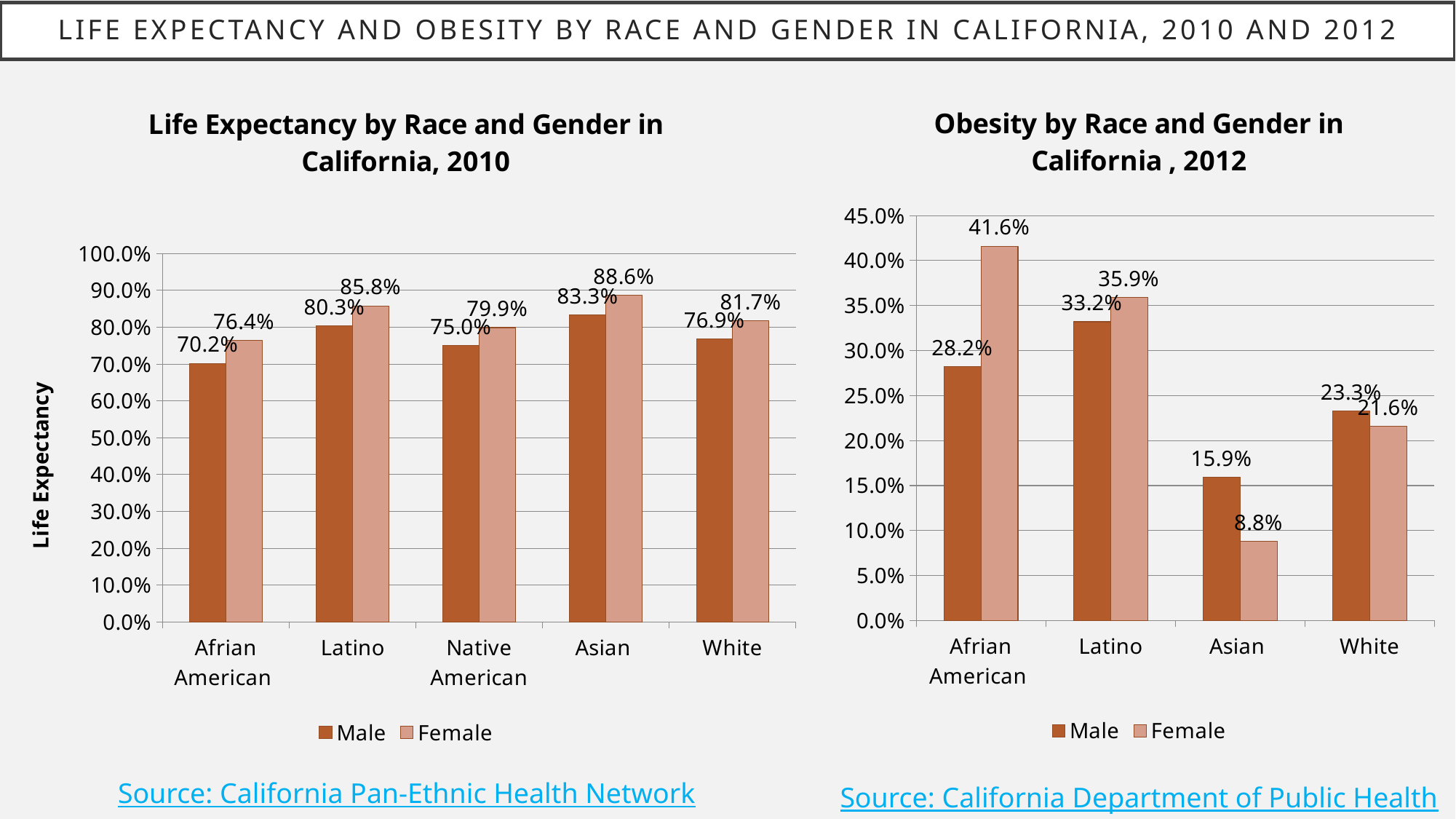
In the Obesity by Race and Gender in California, 2012 chart, which category has the lowest Female value? Asian In the Life Expectancy by Race and Gender in California, 2010 chart, what is the Female value for Native American? 79.9% In the Life Expectancy by Race and Gender in California, 2010 chart, which category has the lowest Male value? Afrian American In the Obesity by Race and Gender in California, 2012 chart, what is the Male value for Asian? 15.9% In the Obesity by Race and Gender in California, 2012 chart, what is the difference between the Female and Male values for Afrian American? 13.4% In the Life Expectancy by Race and Gender in California, 2010 chart, which category has the highest Female value? Asian In the Life Expectancy by Race and Gender in California, 2010 chart, what is the Male value for Asian? 83.3% In the Obesity by Race and Gender in California, 2012 chart, what is the Female value for Afrian American? 41.6% How many series does the legend of the Obesity by Race and Gender in California, 2012 chart list? 2 In the Obesity by Race and Gender in California, 2012 chart, is the Male value or the Female value larger for White? Male How many categories are shown on the x axis of the Life Expectancy by Race and Gender in California, 2010 chart? 5 In the Life Expectancy by Race and Gender in California, 2010 chart, what is the difference between the Female and Male values for Latino? 5.5%